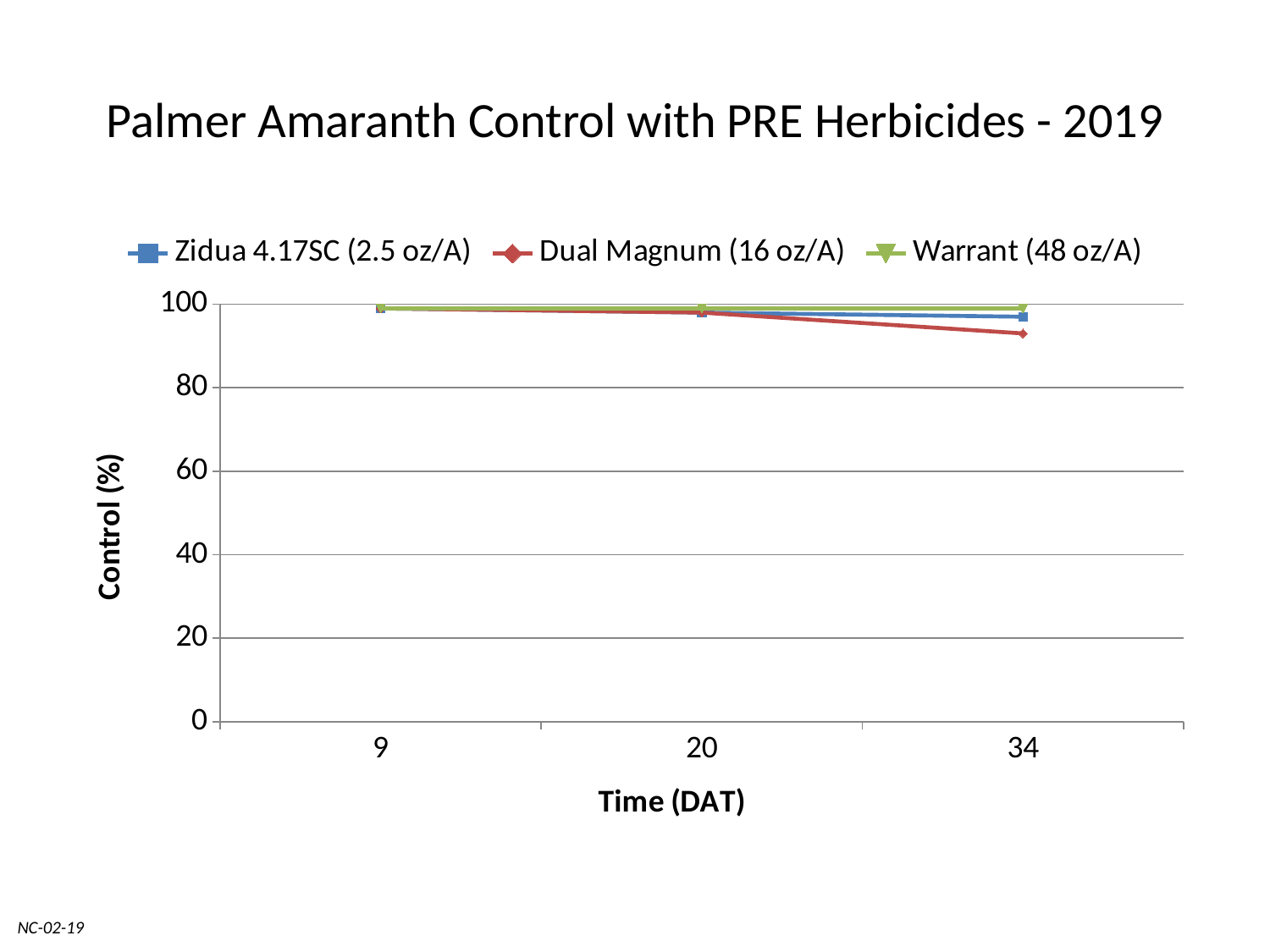
Does the control for Dual Magnum (16 oz/A) rise or fall from 9 DAT to 34 DAT? fall What is the label of the y axis? Control (%) Is the control for Zidua 4.17SC (2.5 oz/A) at 20 DAT greater or less than 60? greater At 34 DAT, which is larger: the control for Warrant (48 oz/A) or for Dual Magnum (16 oz/A)? Warrant (48 oz/A) Is the control for Warrant (48 oz/A) at 9 DAT greater or less than 80? greater What kind of chart is shown on the slide? line chart What is the title of the chart? Palmer Amaranth Control with PRE Herbicides - 2019 At 34 DAT, which is larger: the control for Zidua 4.17SC (2.5 oz/A) or for Dual Magnum (16 oz/A)? Zidua 4.17SC (2.5 oz/A) Which series has the lowest control at 34 DAT? Dual Magnum (16 oz/A) Is the control for Dual Magnum (16 oz/A) at 34 DAT greater or less than 80? greater How many series does the legend list? 3 How many time points are plotted along the x axis? 3